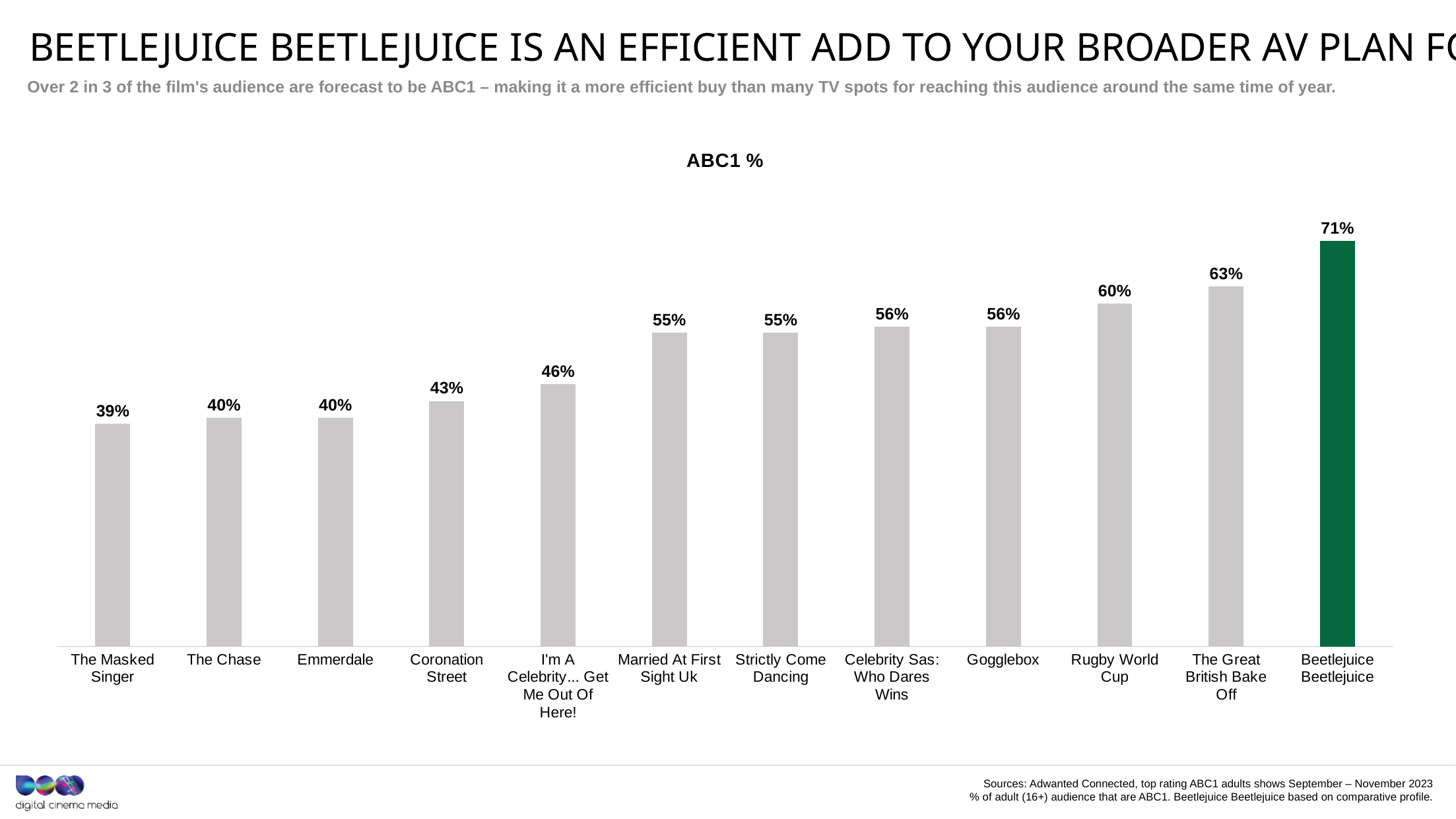
What is the difference in ABC1 % between Rugby World Cup and The Chase? 20% Which has a higher ABC1 % value, Strictly Come Dancing or I'm A Celebrity... Get Me Out Of Here!? Strictly Come Dancing What is the ABC1 % value for Gogglebox? 56% What is the difference in ABC1 % between Beetlejuice Beetlejuice and The Great British Bake Off? 8% What is the ABC1 % value for Coronation Street? 43% Which category has the highest ABC1 % value? Beetlejuice Beetlejuice Which category has the lowest ABC1 % value? The Masked Singer What kind of chart is shown on the slide? Bar chart What is the title of the chart? ABC1 % What is the ABC1 % value for Beetlejuice Beetlejuice? 71% Do the values generally rise or fall from left to right along the x axis? Rise How many categories are shown on the chart? 12